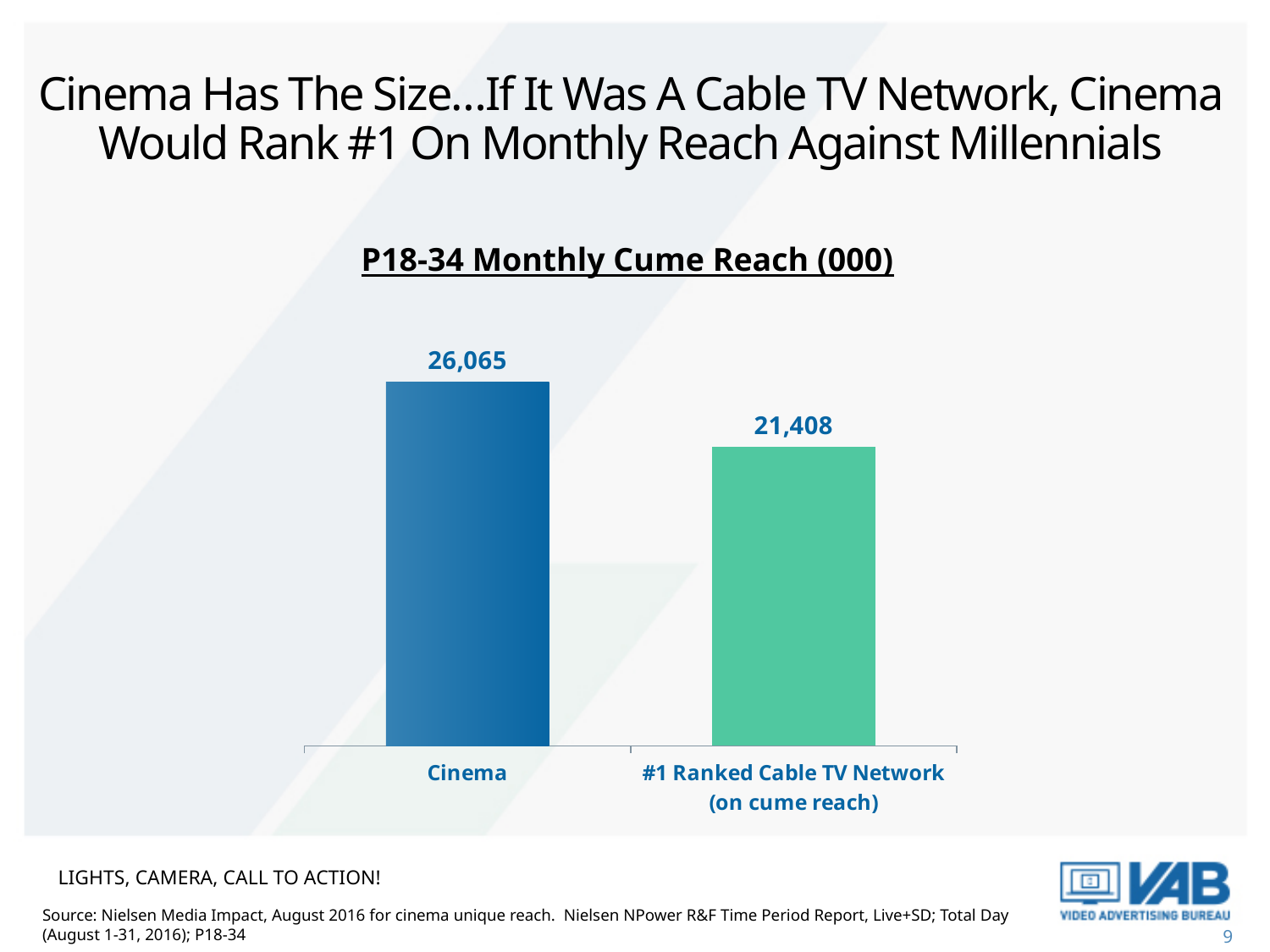
Which category has the higher monthly cume reach? Cinema What is the difference in monthly cume reach (000) between Cinema and the #1 Ranked Cable TV Network? 4,657 How many categories are shown in the chart? 2 What is the title of the chart? P18-34 Monthly Cume Reach (000) Is the monthly cume reach for Cinema larger or smaller than that of the #1 Ranked Cable TV Network? larger What is the P18-34 monthly cume reach (000) for Cinema? 26,065 Which category has the lower monthly cume reach? #1 Ranked Cable TV Network (on cume reach) What kind of chart is shown on the slide? bar chart What colour is the bar for Cinema? blue What is the P18-34 monthly cume reach (000) for the #1 Ranked Cable TV Network (on cume reach)? 21,408